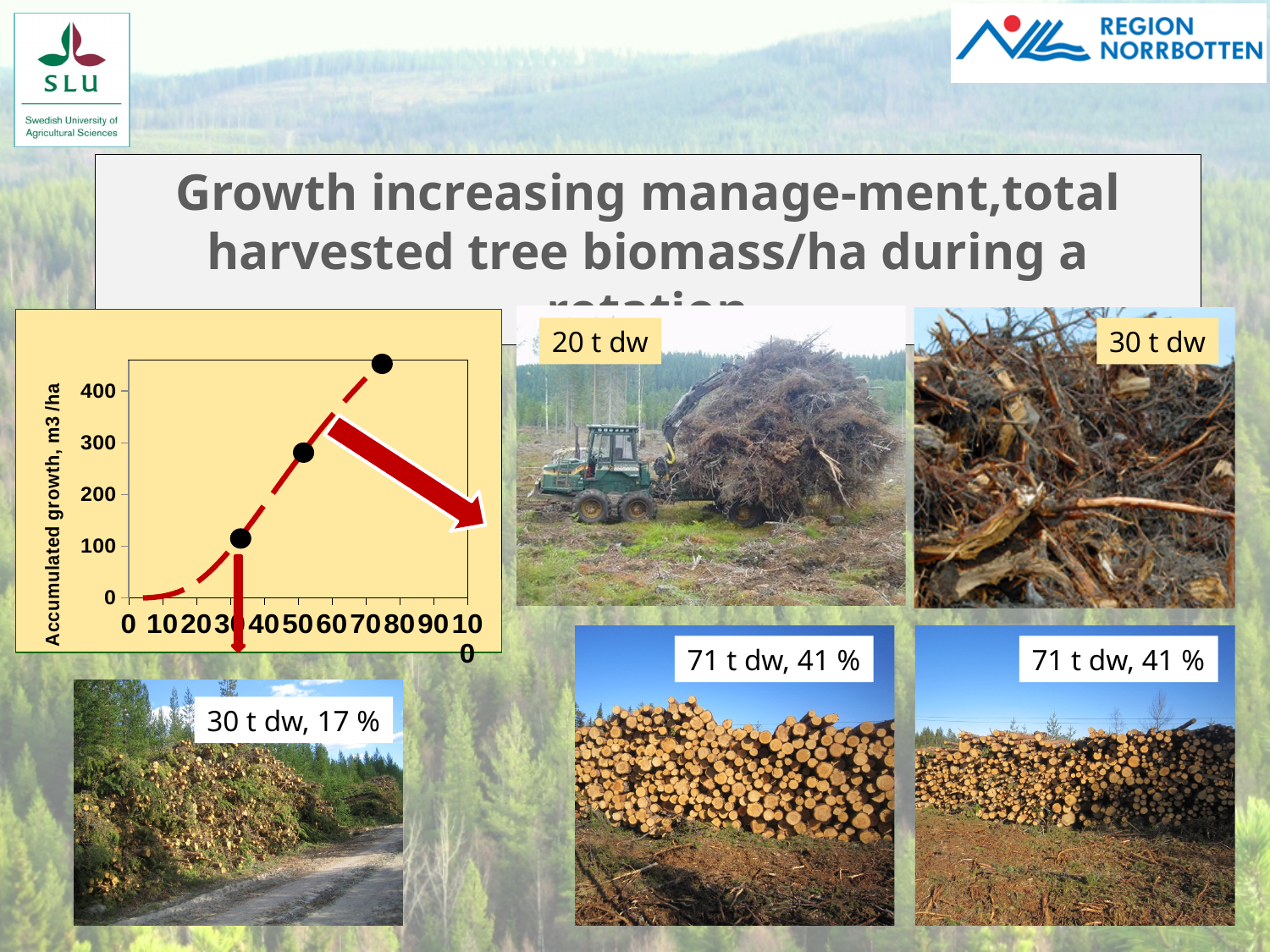
Is the value of the rightmost data point (near x = 75) greater or less than 400? greater Which data point has the highest accumulated growth: the leftmost, middle, or rightmost? rightmost Do the values on the chart rise or fall as you move along the x axis? rise Is the value of the middle data point (near x = 50) greater or less than 300? less Which data point has the lowest accumulated growth: the leftmost, middle, or rightmost? leftmost What kind of chart is shown on the left of the slide? line chart Is the value of the middle data point (near x = 50) greater or less than 200? greater How many data points are marked on the chart? 3 What is the label of the y axis on the chart? Accumulated growth, m3 /ha What is the highest tick value shown on the y axis of the chart? 400 Which is larger, the value of the middle data point or the value of the leftmost data point? middle data point